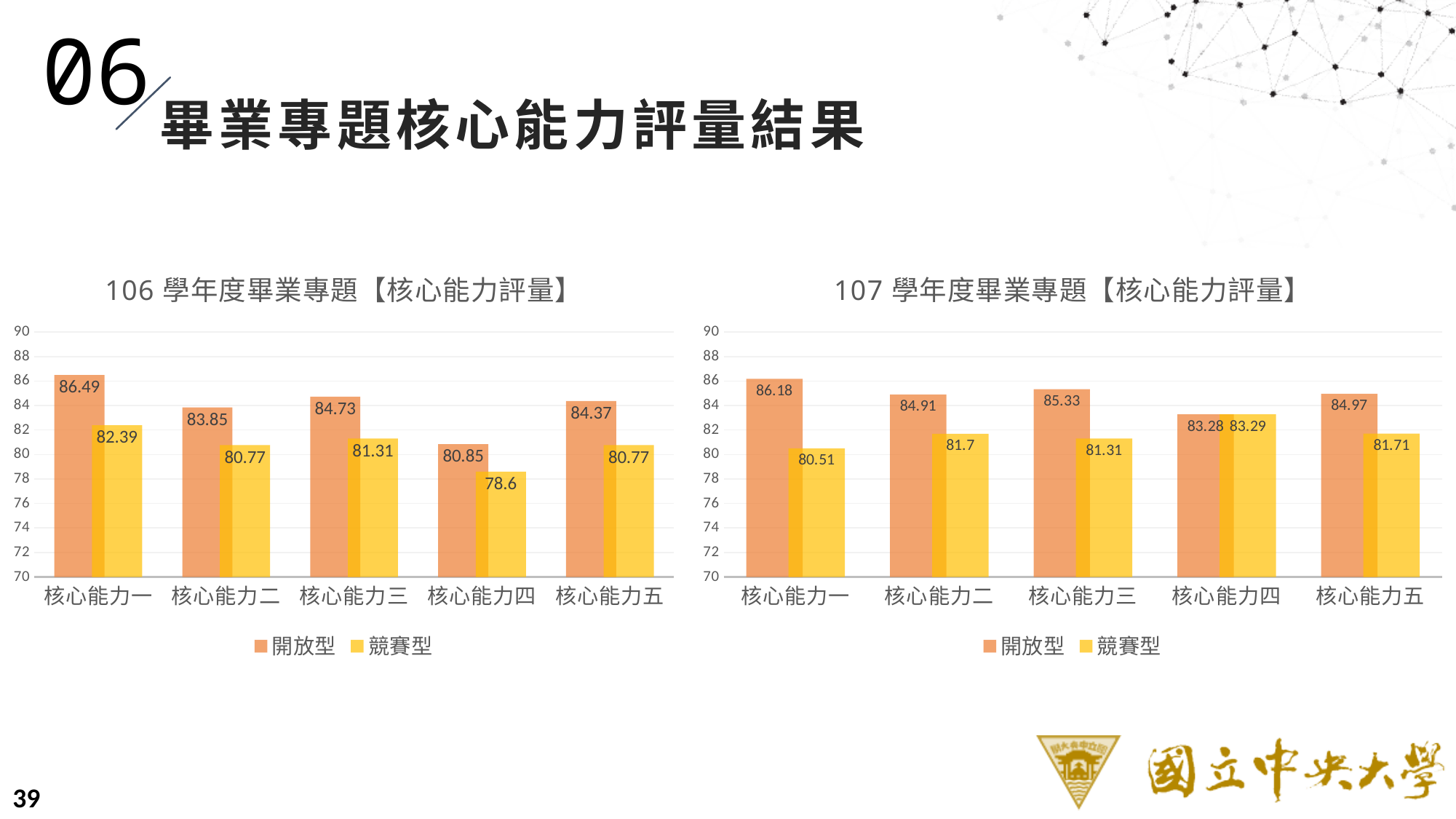
In the 107 學年度畢業專題【核心能力評量】 chart, what is the 開放型 value for 核心能力三? 85.33 In the 106 學年度畢業專題【核心能力評量】 chart, what is the difference between the 開放型 and 競賽型 values for 核心能力一? 4.1 In the 107 學年度畢業專題【核心能力評量】 chart, what is the 競賽型 value for 核心能力二? 81.7 In the 106 學年度畢業專題【核心能力評量】 chart, what is the 競賽型 value for 核心能力四? 78.6 In the 107 學年度畢業專題【核心能力評量】 chart, which category has the highest 開放型 value? 核心能力一 What kind of chart is the 106 學年度畢業專題【核心能力評量】 chart? bar chart In the 106 學年度畢業專題【核心能力評量】 chart, what is the 開放型 value for 核心能力一? 86.49 In the 107 學年度畢業專題【核心能力評量】 chart, what is the difference between the 開放型 and 競賽型 values for 核心能力五? 3.26 In the 106 學年度畢業專題【核心能力評量】 chart, how many categories are shown on the x axis? 5 In the 106 學年度畢業專題【核心能力評量】 chart, which category has the lowest 競賽型 value? 核心能力四 In the 107 學年度畢業專題【核心能力評量】 chart, which is larger for 核心能力一: the 開放型 value or the 競賽型 value? 開放型 How many series does the legend of the 107 學年度畢業專題【核心能力評量】 chart list? 2